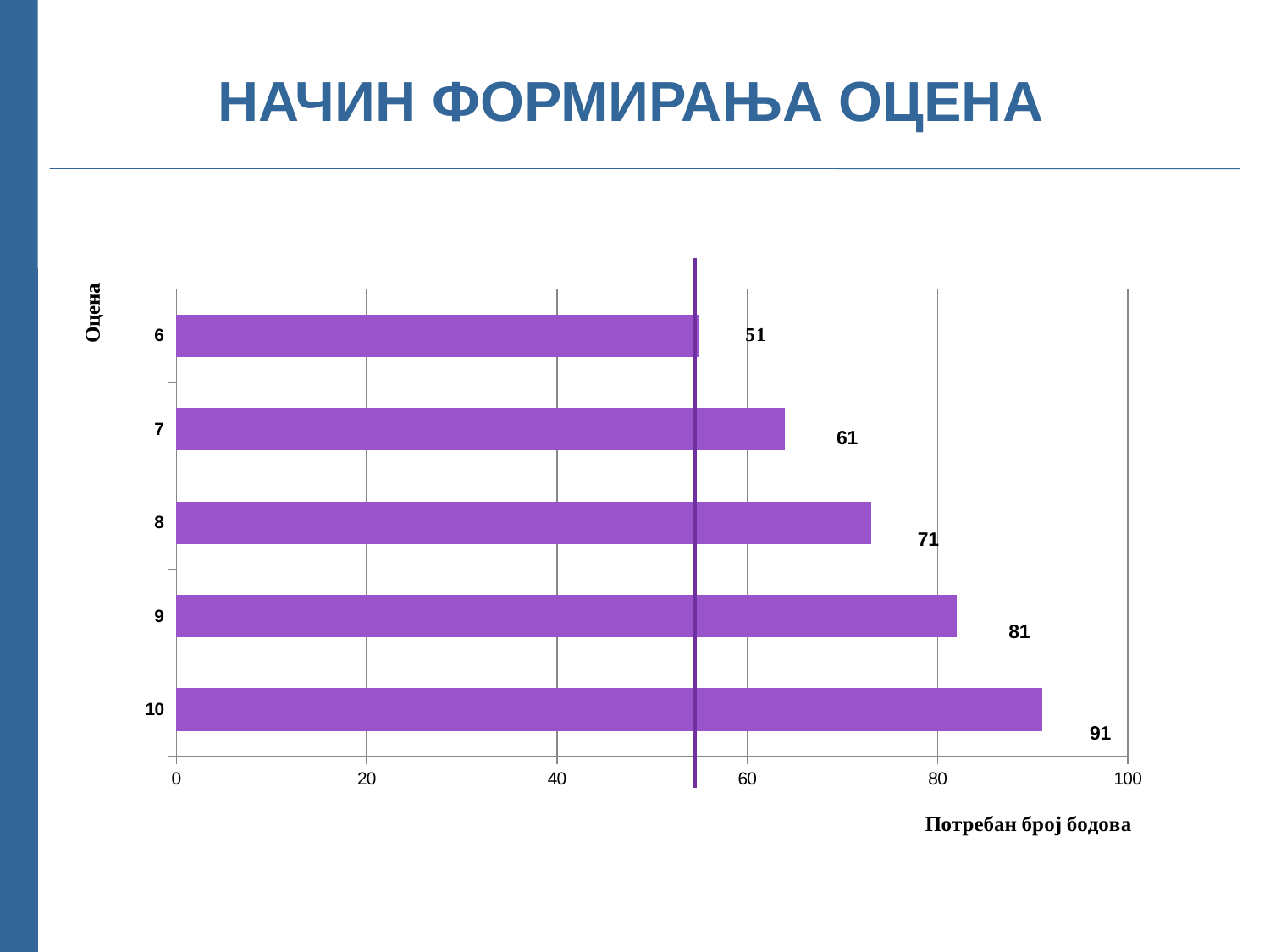
How many grade categories are plotted on the chart? 5 What is the required number of points for grade 8? 71 What kind of chart is shown on the slide? bar chart Which requires more points, grade 8 or grade 7? grade 8 Is the value for grade 9 greater or less than 60? greater What is the label of the horizontal axis of the chart? Потребан број бодова What is the title of the slide containing the chart? НАЧИН ФОРМИРАЊА ОЦЕНА Which grade requires the highest number of points? 10 What is the required number of points (Потребан број бодова) for grade 6? 51 Which grade requires the lowest number of points? 6 What is the difference between the points required for grade 9 and grade 7? 20 What is the required number of points for grade 10? 91